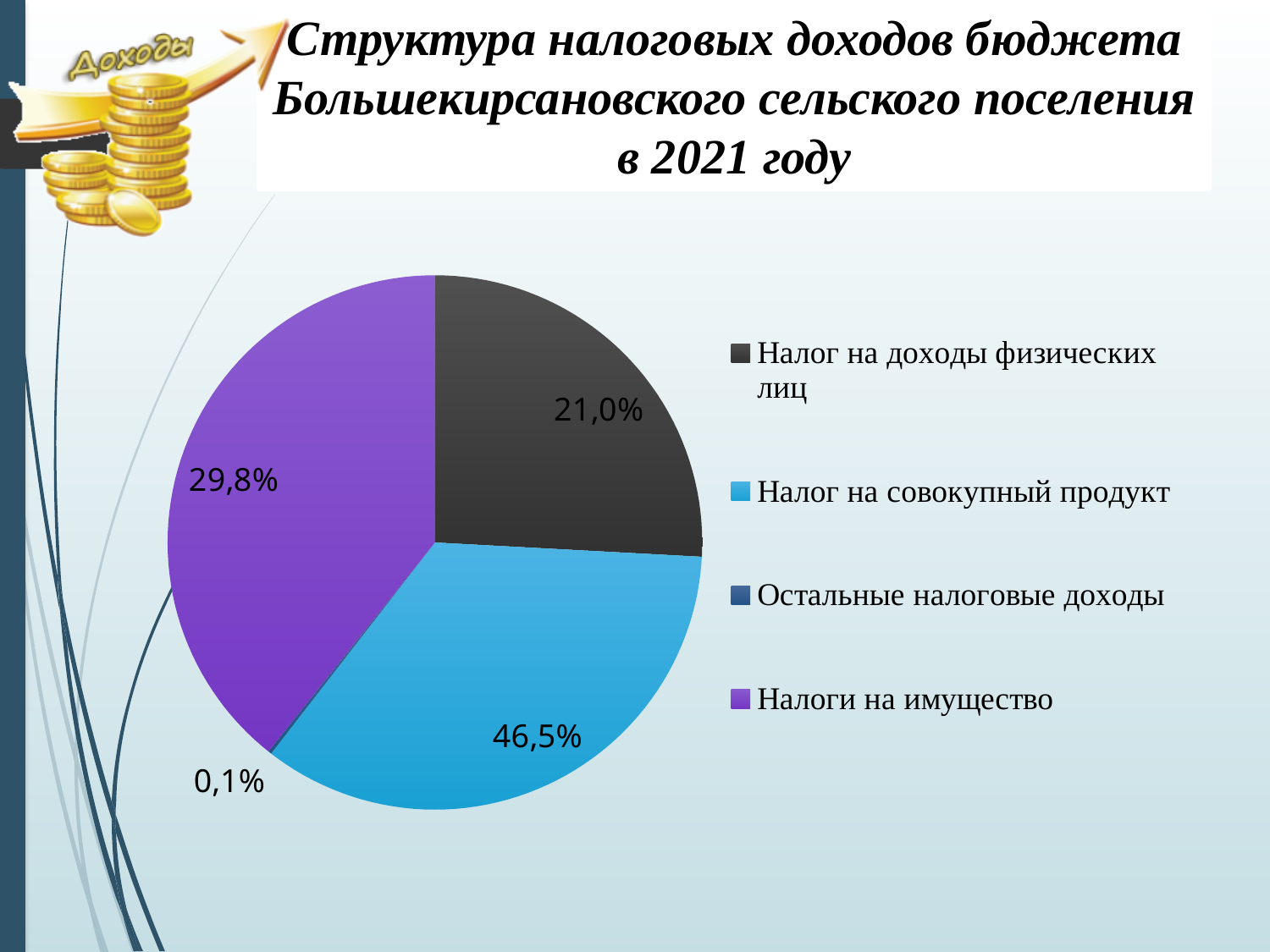
Which category has the largest share of the pie? Налог на совокупный продукт Which category has the smallest share of the pie? Остальные налоговые доходы What kind of chart is shown on the slide? Pie chart What is the difference in percentage points between "Налоги на имущество" and "Налог на доходы физических лиц"? 8,8 What share of tax revenues does "Остальные налоговые доходы" account for? 0,1% What is the difference in percentage points between "Налог на совокупный продукт" and "Налоги на имущество"? 16,7 What share of tax revenues does "Налог на совокупный продукт" account for? 46,5% What colour is the slice for "Налог на совокупный продукт"? Light blue Which is larger: the share of "Налоги на имущество" or the share of "Налог на доходы физических лиц"? Налоги на имущество How many categories does the legend list? 4 What share of tax revenues does "Налог на доходы физических лиц" account for? 21,0% What share of tax revenues does "Налоги на имущество" account for? 29,8%